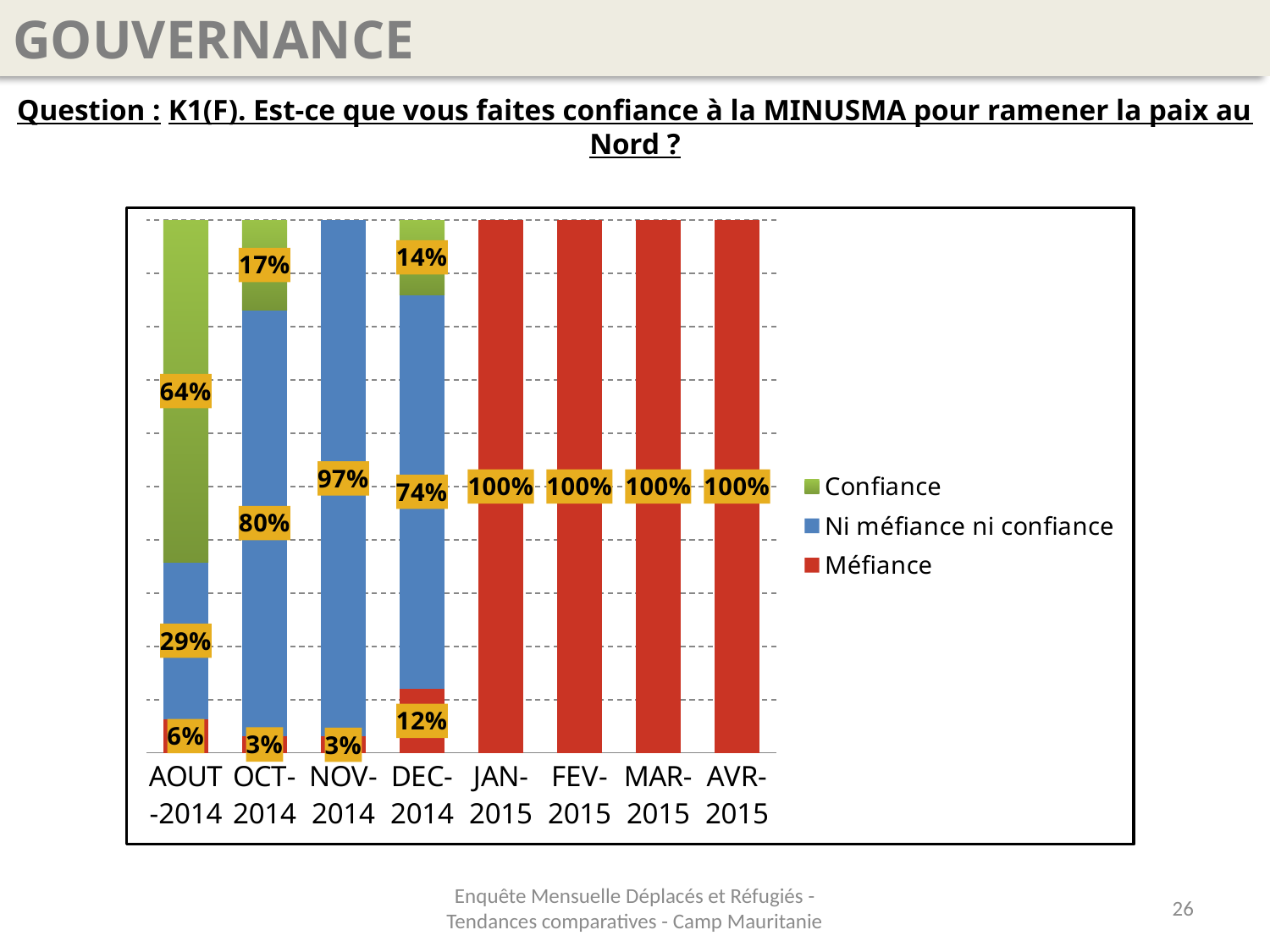
What is the value for Ni méfiance ni confiance in NOV-2014? 97% How many series does the legend list? 3 Which series is shown in red in the legend? Méfiance What is the value for Méfiance in DEC-2014? 12% What is the value for Méfiance in JAN-2015? 100% Which is larger, the Confiance value in OCT-2014 or in DEC-2014? OCT-2014 What is the difference between the Ni méfiance ni confiance values in OCT-2014 and DEC-2014? 6% How many months (categories) are shown on the x axis? 8 What kind of chart is shown on the slide? stacked bar chart In which month is the Confiance value highest? AOUT-2014 In which month is the Ni méfiance ni confiance value highest? NOV-2014 What is the value for Confiance in AOUT-2014? 64%